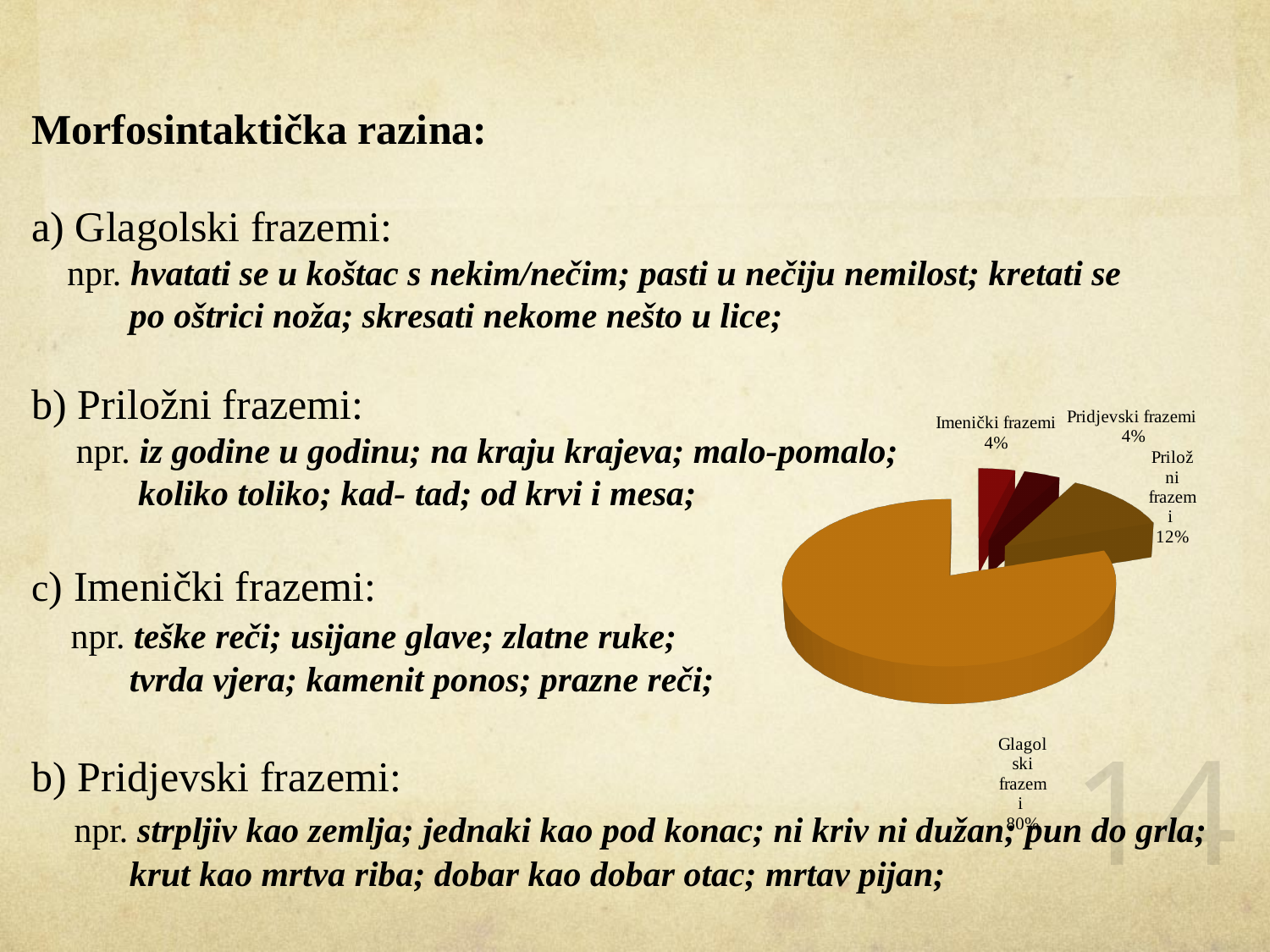
Which two categories in the pie chart have the same share? Imenički frazemi and Pridjevski frazemi What is the difference in percentage points between Glagolski frazemi and Priložni frazemi in the pie chart? 68 Which is larger in the pie chart, Priložni frazemi or Imenički frazemi? Priložni frazemi What is the difference in percentage points between Priložni frazemi and Pridjevski frazemi in the pie chart? 8 What share of the pie chart is Imenički frazemi? 4% What colour is the largest slice of the pie chart? orange Which category has the largest slice in the pie chart? Glagolski frazemi What share of the pie chart is Priložni frazemi? 12% What kind of chart is shown on the slide? pie chart What share of the pie chart is Pridjevski frazemi? 4% How many slices does the pie chart have? 4